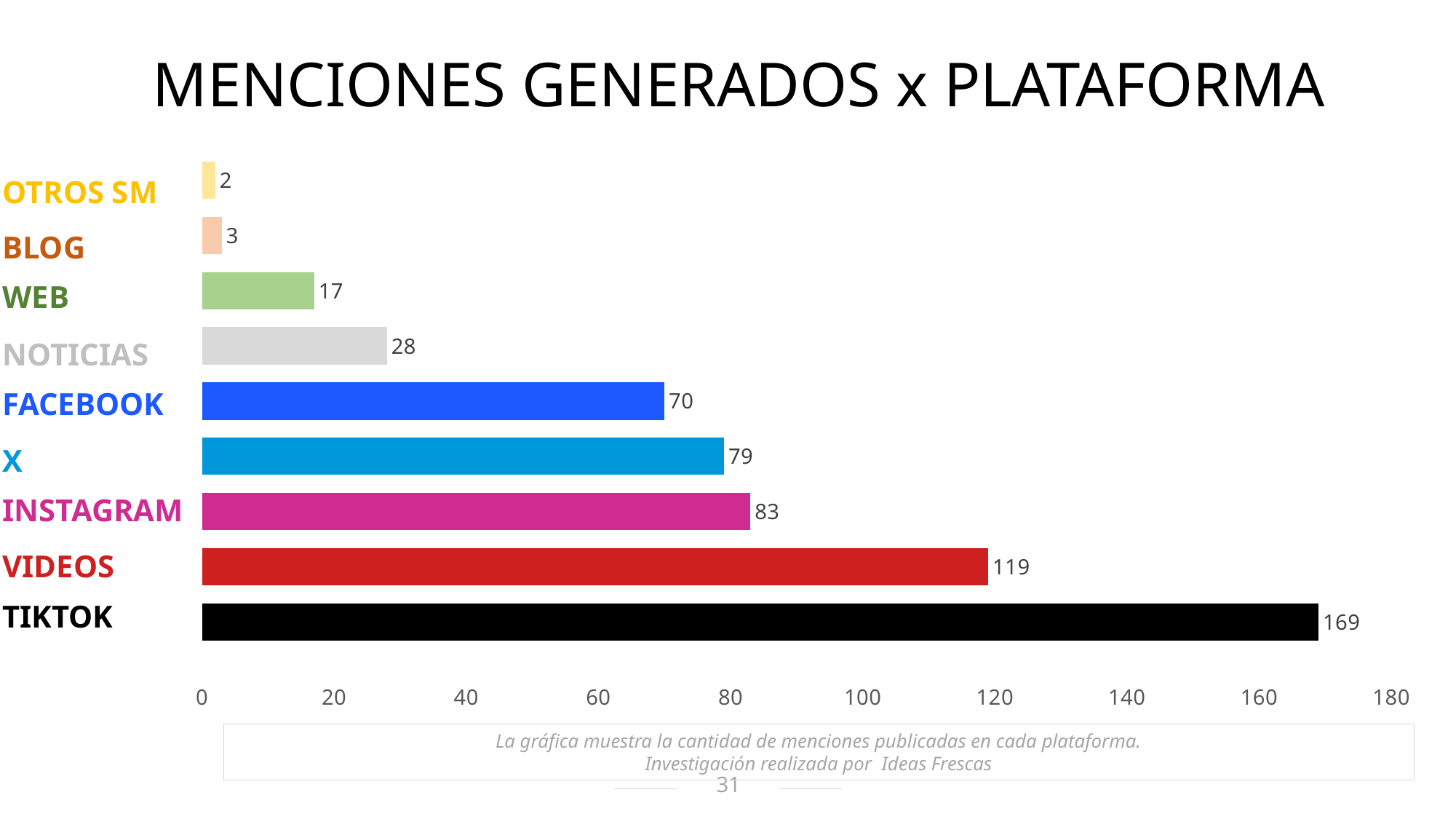
Is the value for VIDEOS greater or less than 100? greater What is the value for TIKTOK? 169 Which is larger, the value for INSTAGRAM or the value for X? INSTAGRAM How many platforms are shown in the chart? 9 What is the value for NOTICIAS? 28 What is the difference between the values for X and FACEBOOK? 9 What is the value for INSTAGRAM? 83 What is the title of the chart? MENCIONES GENERADOS x PLATAFORMA What is the difference between the values for TIKTOK and VIDEOS? 50 Which platform has the lowest number of mentions? OTROS SM What kind of chart is shown on the slide? bar chart Which platform has the highest number of mentions? TIKTOK